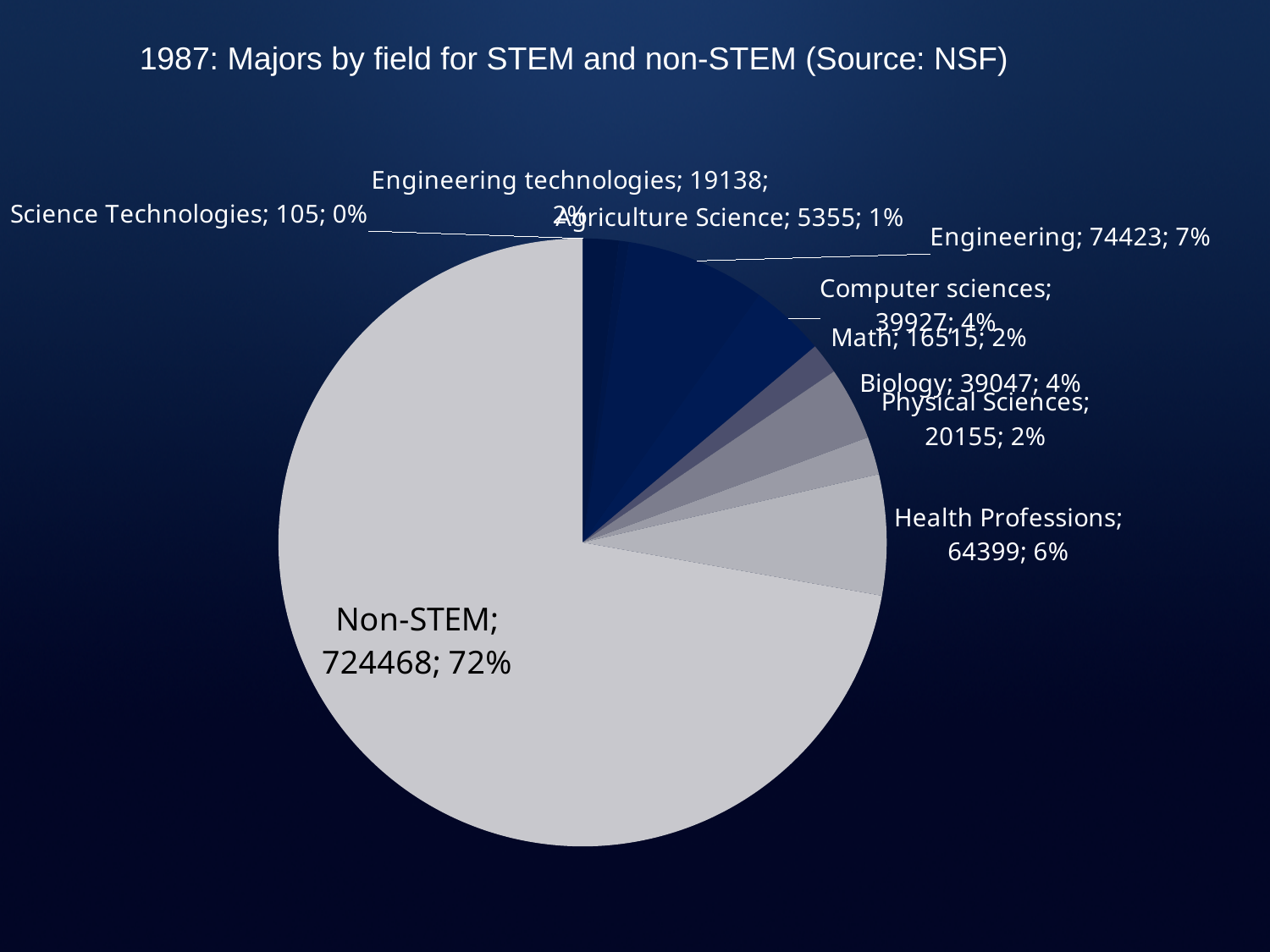
What is the title of the chart? 1987: Majors by field for STEM and non-STEM (Source: NSF) What kind of chart is shown on the slide? pie chart What is the value shown for Health Professions? 64399 What share of the pie does Non-STEM represent? 72% What is the difference between the values for Engineering and Health Professions? 10024 Which has a larger value, Biology or Math? Biology What is the value shown for Engineering? 74423 How many categories are shown in the pie chart? 10 What share of the pie does Engineering represent? 7% Which category has the smallest slice of the pie? Science Technologies What is the value shown for Non-STEM? 724468 Which category has the largest slice of the pie? Non-STEM